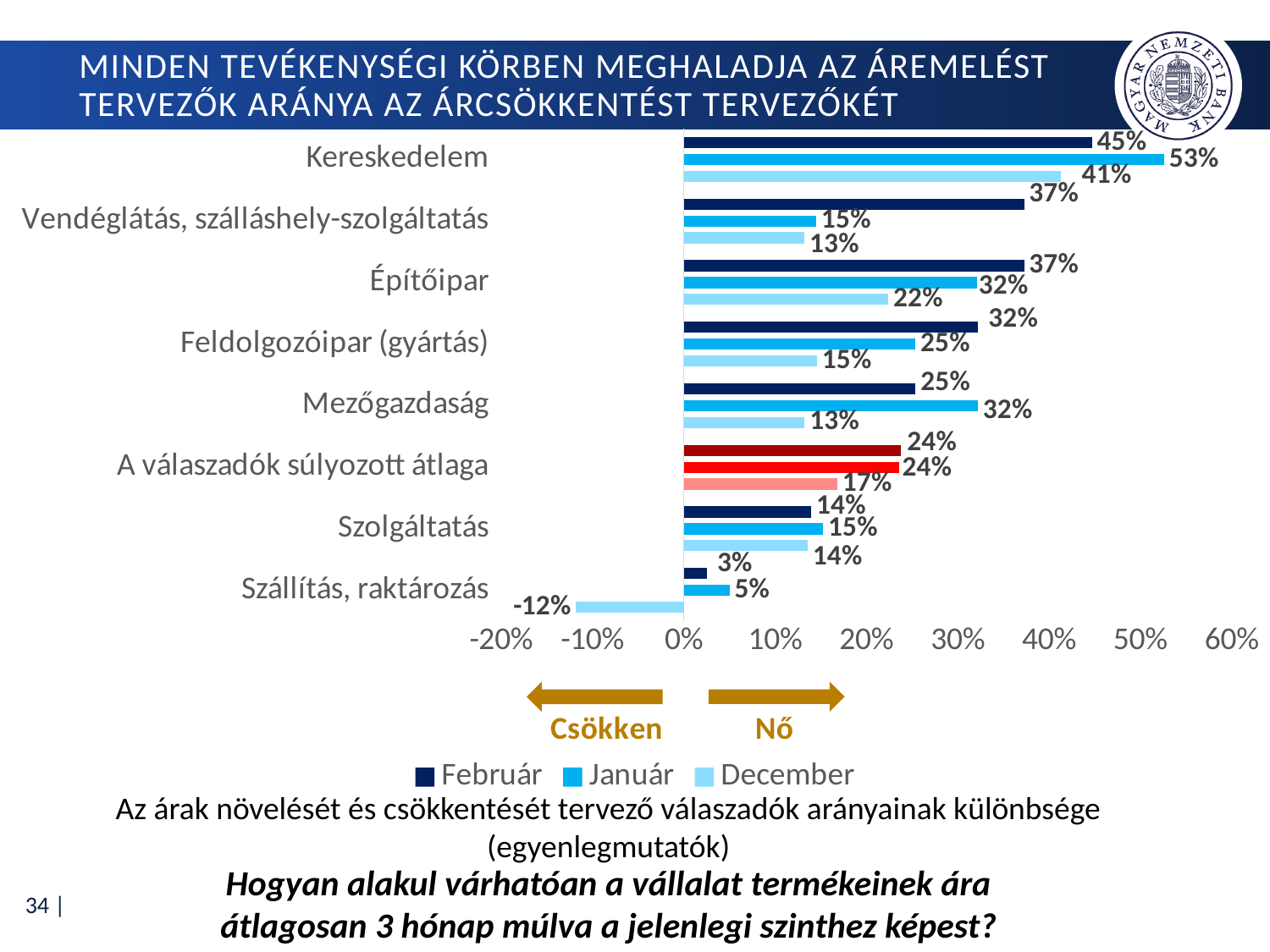
What is the Február value for Feldolgozóipar (gyártás)? 32% Which category has the lowest December value? Szállítás, raktározás Is the Február value for Vendéglátás, szálláshely-szolgáltatás greater or less than 30%? greater Which series is shown in the lightest blue colour in the legend? December What is the December value for Szállítás, raktározás? -12% Which is larger for Mezőgazdaság: the Február value or the Január value? Január How many categories are shown on the chart? 8 Which category has the highest Február value? Kereskedelem What is the difference between the Január and December values for Építőipar? 10% How many series does the legend list? 3 What is the Január value for Kereskedelem? 53% What kind of chart is shown on the slide? bar chart